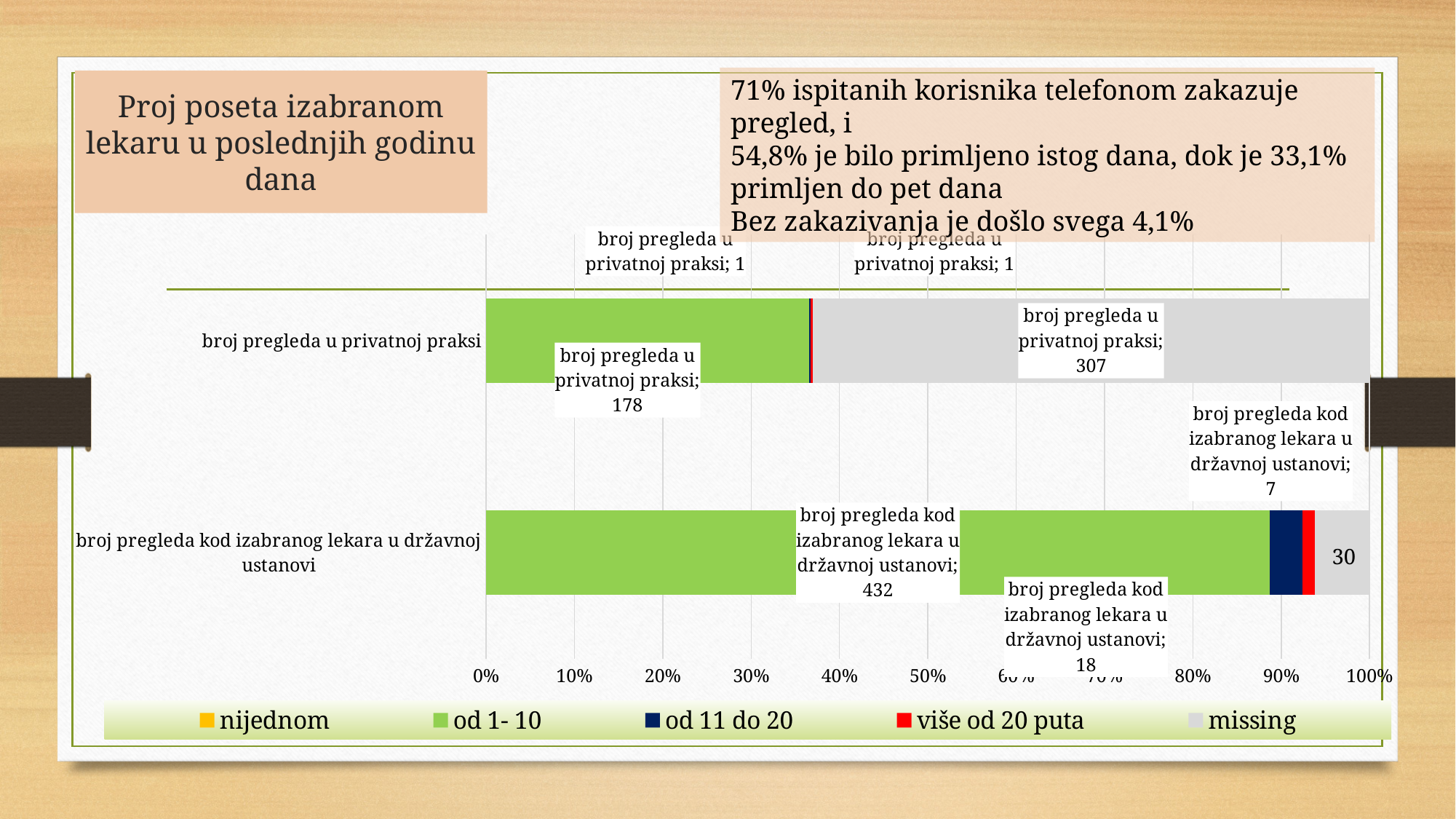
Is the share of the 'od 1- 10' segment in the 'broj pregleda u privatnoj praksi' bar greater or less than 40%? less Which category has the larger 'od 1- 10' value: 'broj pregleda u privatnoj praksi' or 'broj pregleda kod izabranog lekara u državnoj ustanovi'? broj pregleda kod izabranog lekara u državnoj ustanovi What is the 'missing' value for 'broj pregleda u privatnoj praksi'? 307 What is the value of 'od 1- 10' for 'broj pregleda u privatnoj praksi'? 178 What is the difference between the 'od 1- 10' values for 'broj pregleda kod izabranog lekara u državnoj ustanovi' (432) and 'broj pregleda u privatnoj praksi' (178)? 254 How many categories (bars) are plotted in the chart? 2 What is the value of 'od 1- 10' for 'broj pregleda kod izabranog lekara u državnoj ustanovi'? 432 Which colour does the legend use for the 'missing' series? Grey How many series does the chart legend list? 5 What is the 'missing' value for 'broj pregleda kod izabranog lekara u državnoj ustanovi'? 30 What kind of chart is shown on the slide? Stacked bar chart What is the difference between the 'missing' values for 'broj pregleda u privatnoj praksi' (307) and 'broj pregleda kod izabranog lekara u državnoj ustanovi' (30)? 277